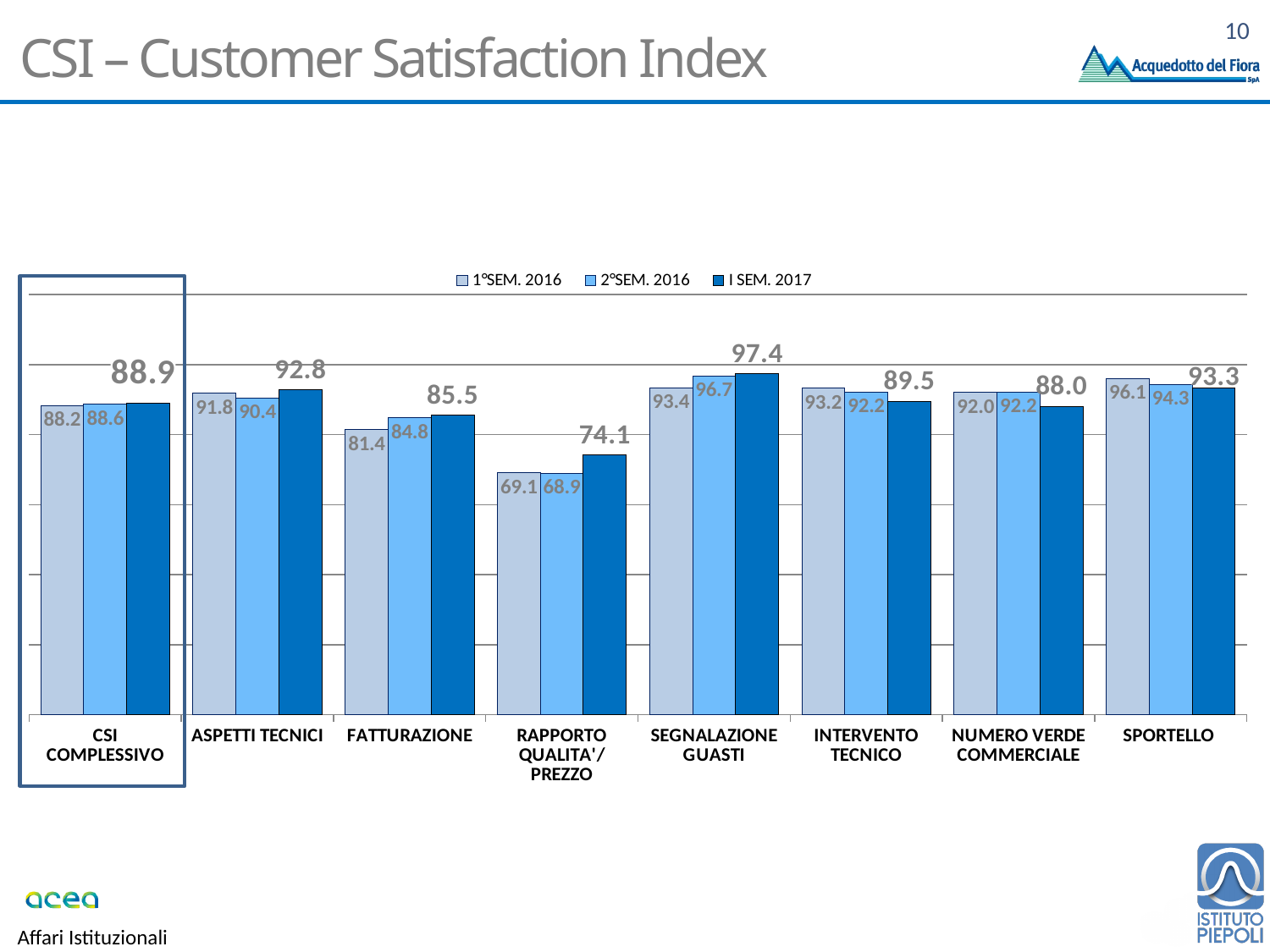
Do the SPORTELLO values rise or fall from 1°SEM. 2016 to I SEM. 2017? fall What is the 2°SEM. 2016 value for SEGNALAZIONE GUASTI? 96.7 Which category has the lowest I SEM. 2017 value? RAPPORTO QUALITA'/PREZZO For INTERVENTO TECNICO, which is larger: the 1°SEM. 2016 value or the I SEM. 2017 value? 1°SEM. 2016 What is the I SEM. 2017 value for CSI COMPLESSIVO? 88.9 How many categories are shown on the x axis? 8 Which category has the highest I SEM. 2017 value? SEGNALAZIONE GUASTI What is the difference between the I SEM. 2017 and 2°SEM. 2016 values for RAPPORTO QUALITA'/PREZZO? 5.2 What is the 1°SEM. 2016 value for FATTURAZIONE? 81.4 Which category is highlighted with a box outline on the chart? CSI COMPLESSIVO What type of chart is shown on the slide? bar chart How many series does the legend list? 3